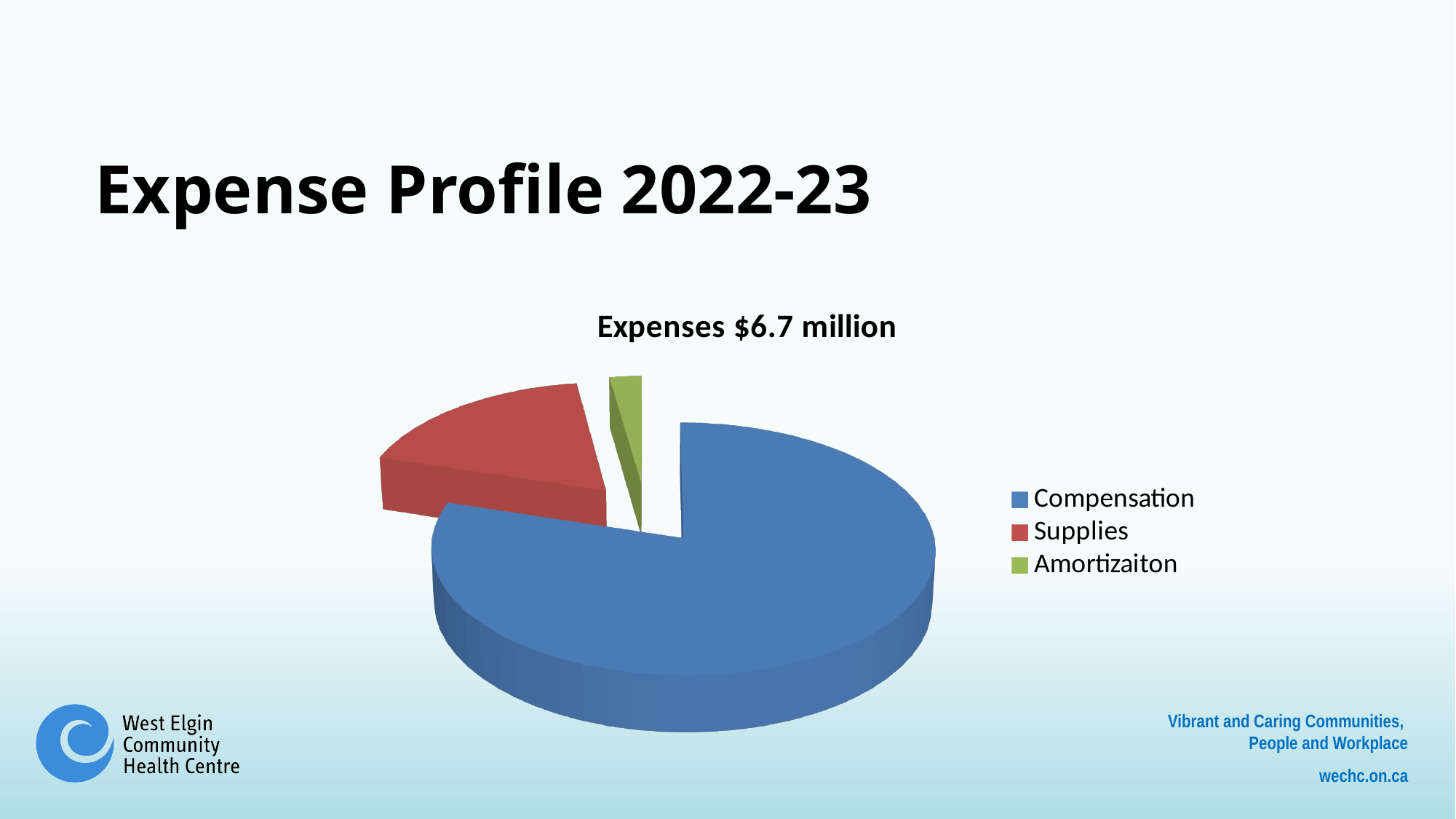
What colour is the Supplies slice? Red What kind of chart is shown on the slide? Pie chart Which slice is larger, Supplies or Amortizaiton? Supplies How many entries does the legend list? 3 Which category has the largest slice of the pie? Compensation What total expense amount is stated in the chart title? $6.7 million Which slice is larger, Compensation or Supplies? Compensation How many categories does the pie chart show? 3 Which category has the smallest slice of the pie? Amortizaiton What is the title of the chart? Expenses $6.7 million